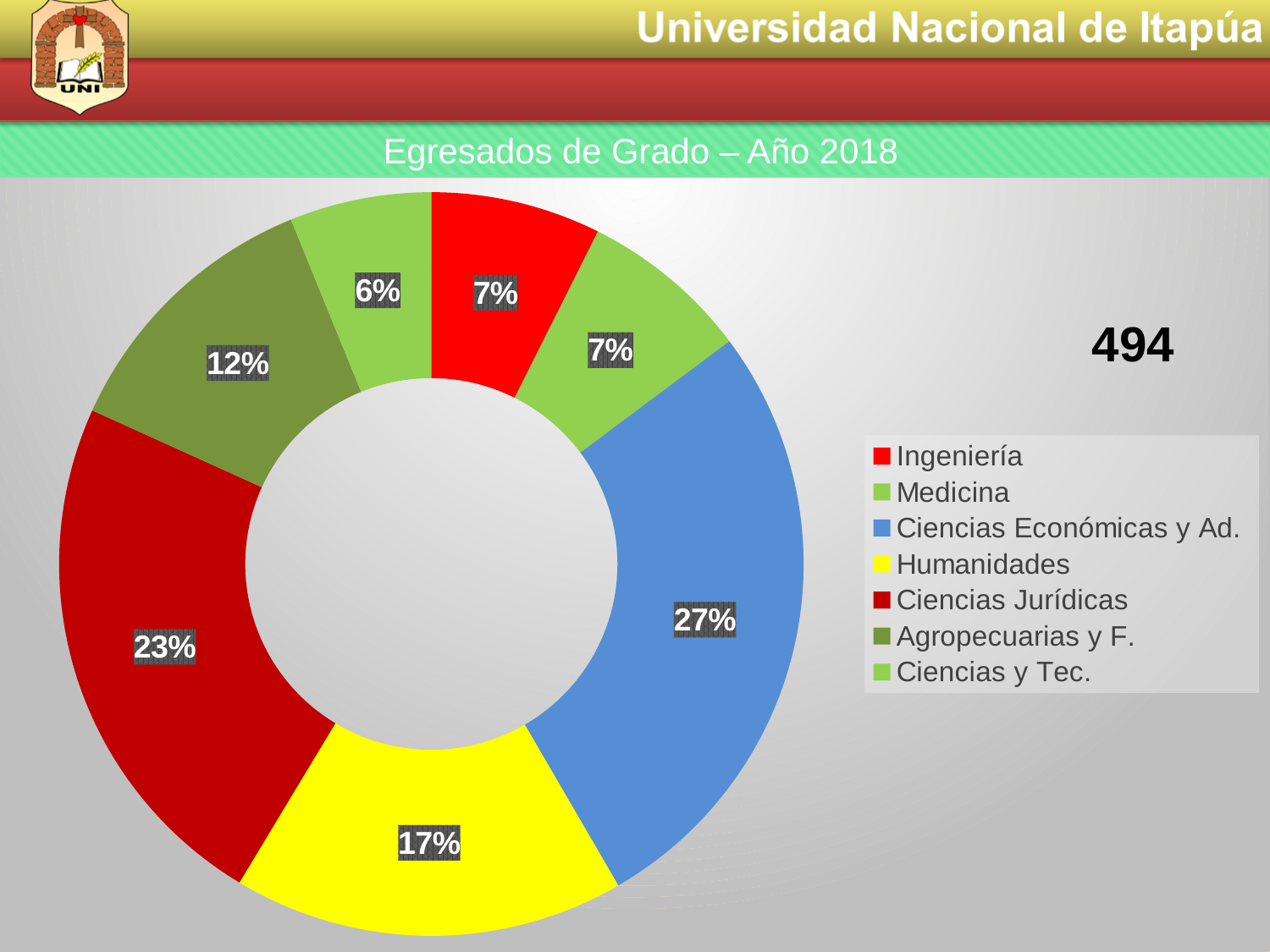
What percentage is shown for Agropecuarias y F.? 12% What share of the chart does Ciencias Económicas y Ad. represent? 27% What percentage is shown for Ciencias y Tec.? 6% What kind of chart is shown on the slide? doughnut chart What is the difference in percentage points between Ciencias Económicas y Ad. and Ciencias Jurídicas? 4 Which category has the largest share of the chart? Ciencias Económicas y Ad. Which has a larger share, Humanidades or Agropecuarias y F.? Humanidades What is the title of the chart? Egresados de Grado – Año 2018 What percentage is shown for Ciencias Jurídicas? 23% How many categories are shown in the chart? 7 Which category has the smallest share of the chart? Ciencias y Tec. What percentage is shown for Humanidades? 17%